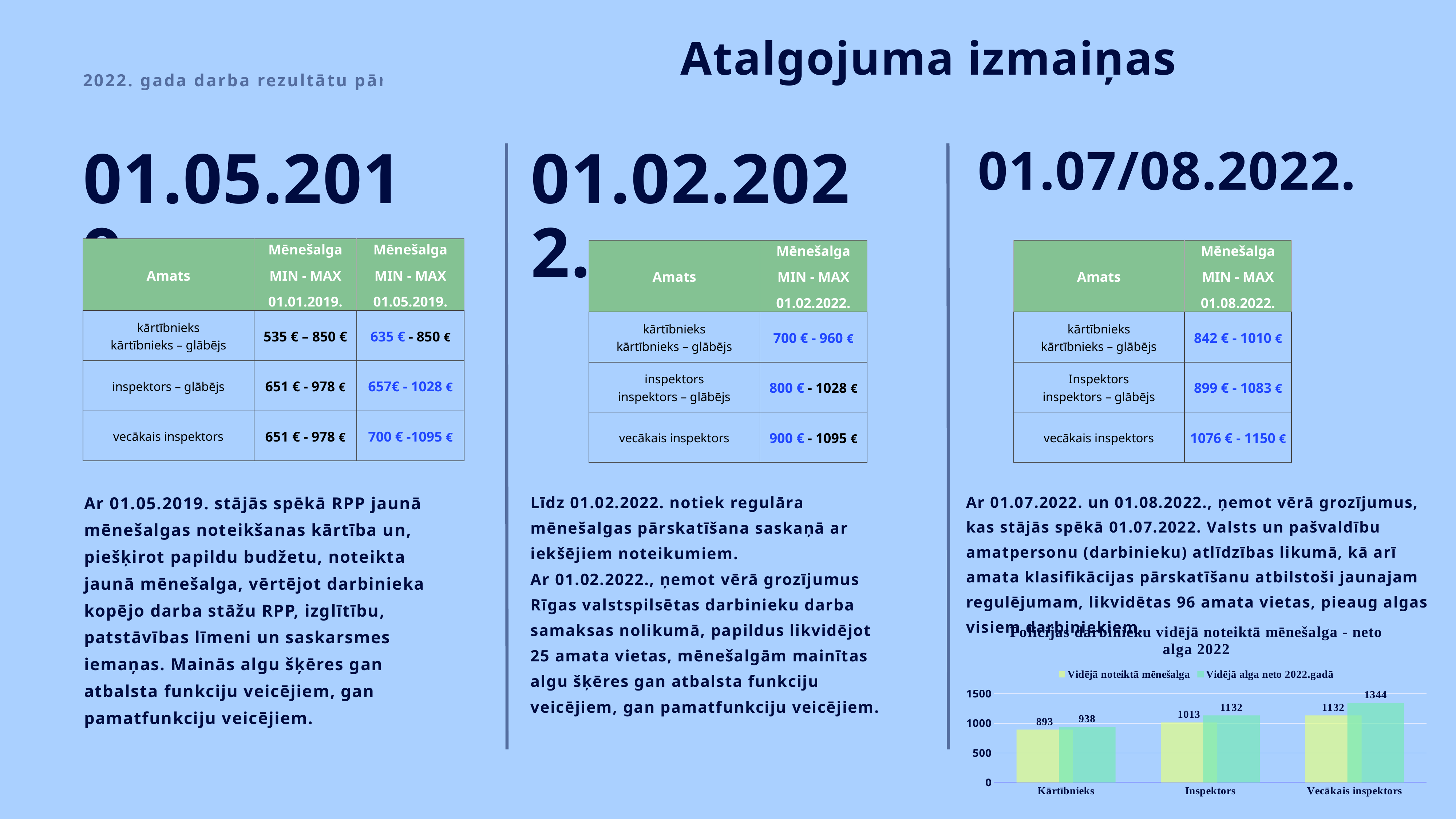
What is the difference between Vidējā alga neto 2022.gadā and Vidējā noteiktā mēnešalga for Kārtībnieks? 45 How many series does the chart legend list? 2 What is the difference between Vidējā alga neto 2022.gadā and Vidējā noteiktā mēnešalga for Vecākais inspektors? 212 How many categories are shown on the x axis of the chart? 3 Which category has the highest Vidējā alga neto 2022.gadā in the chart? Vecākais inspektors What kind of chart is shown on the slide? Bar chart What is the value of Vidējā alga neto 2022.gadā for Vecākais inspektors in the chart? 1344 What is the value of Vidējā alga neto 2022.gadā for Inspektors in the chart? 1132 Which category has the lowest Vidējā noteiktā mēnešalga in the chart? Kārtībnieks Do the Vidējā noteiktā mēnešalga values rise or fall from Kārtībnieks to Vecākais inspektors? Rise Which is larger in the chart: Vidējā noteiktā mēnešalga for Inspektors or Vidējā alga neto 2022.gadā for Kārtībnieks? Vidējā noteiktā mēnešalga for Inspektors What is the value of Vidējā noteiktā mēnešalga for Kārtībnieks in the chart? 893